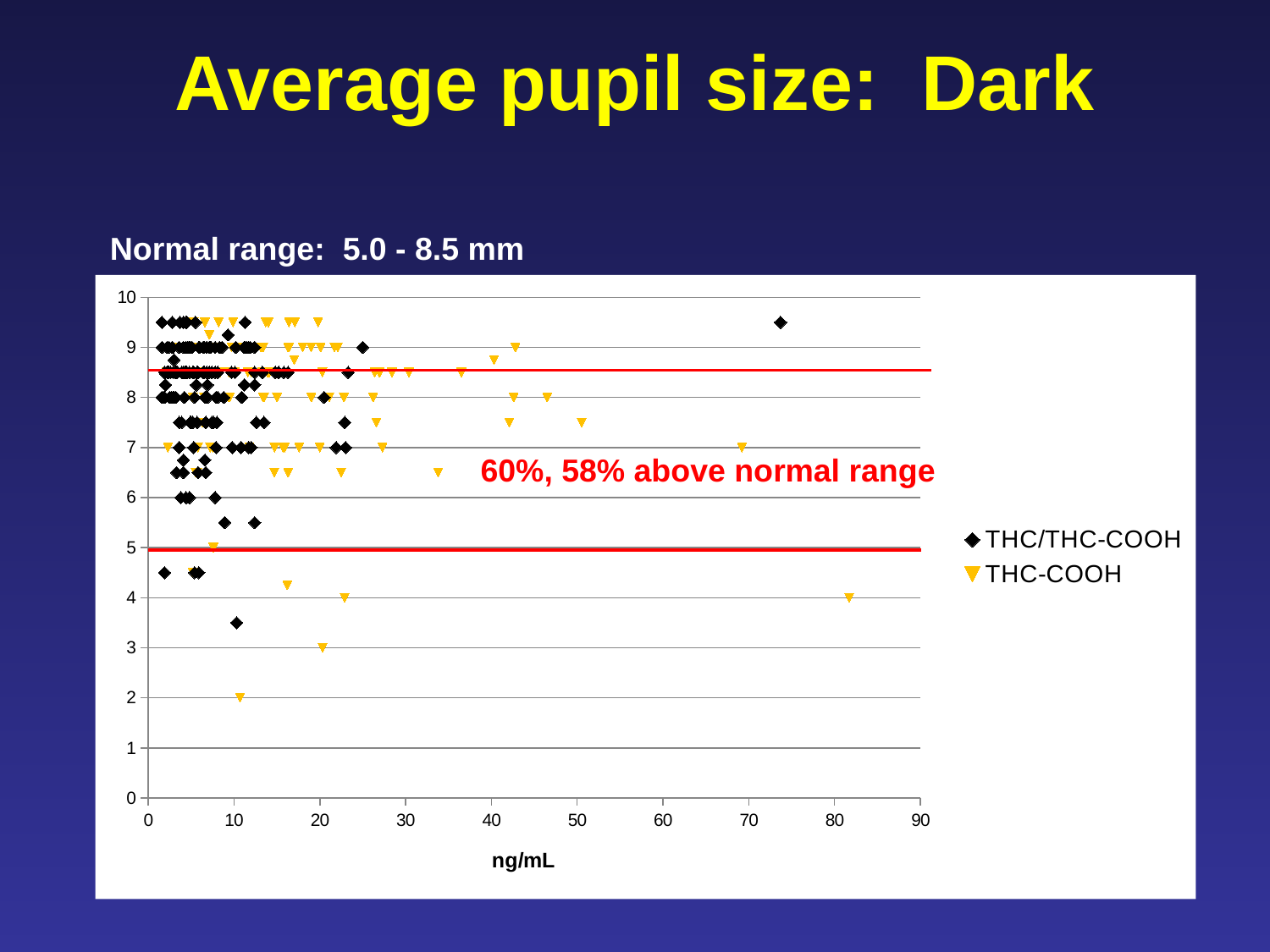
Is the THC-COOH point plotted near 43 ng/mL at the top of the chart greater or less than 8.5? greater What is the label on the x axis of the chart? ng/mL What kind of chart is shown on the slide? scatter chart How many series does the chart legend list? 2 Is the THC/THC-COOH point plotted near 74 ng/mL greater or less than 9? greater Which series contains the point plotted at the highest concentration (furthest right) on the chart? THC-COOH Is the THC-COOH point plotted near 82 ng/mL greater or less than 5? less Which series contains the point with the lowest pupil size on the chart? THC-COOH What are the two series named in the chart legend? THC/THC-COOH and THC-COOH